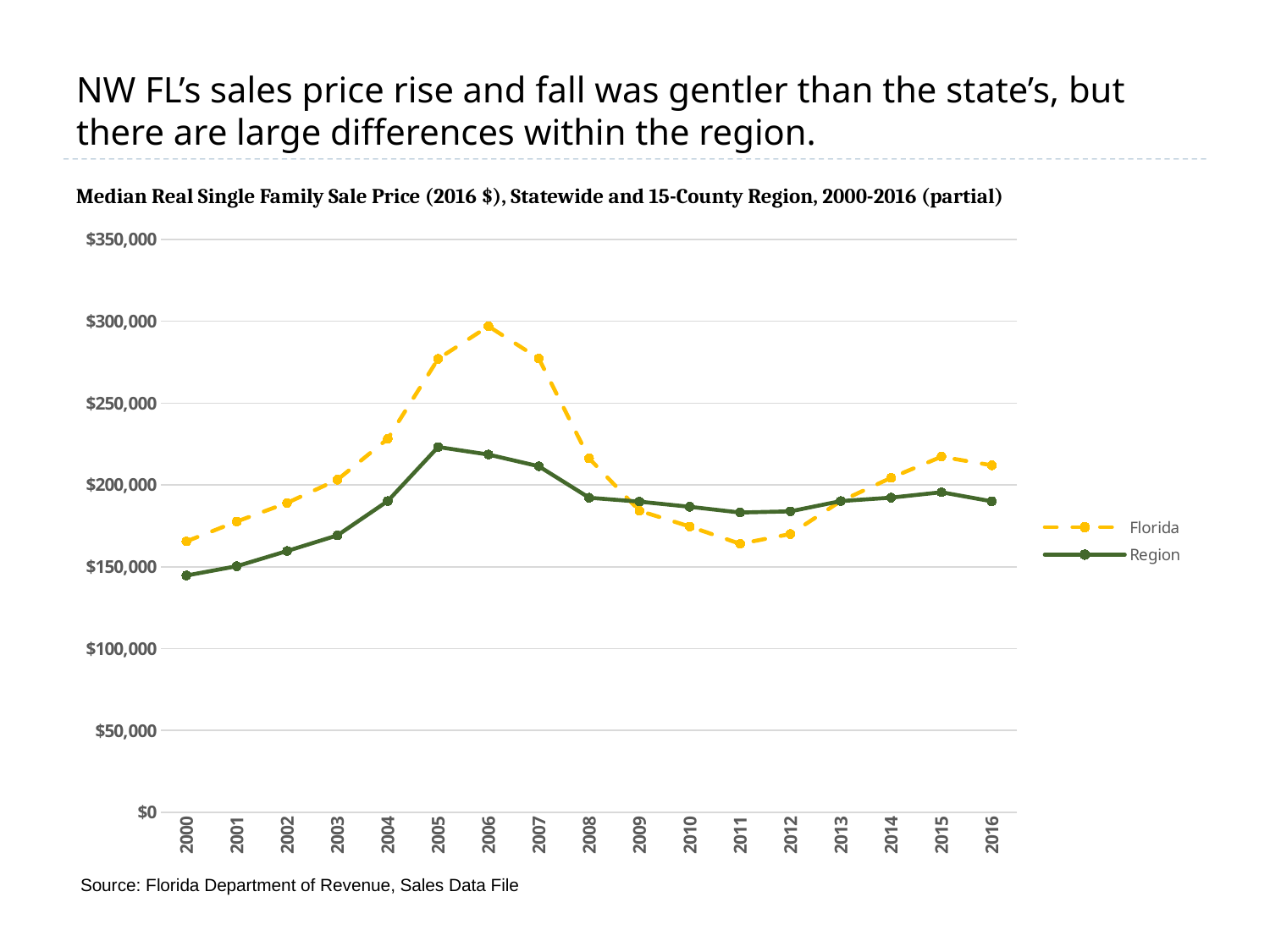
Is the Region value for 2005 greater or less than $200,000? greater Is the Region value for 2000 greater or less than $150,000? less Does the Florida series rise or fall between 2006 and 2011? fall Is the Florida value for 2006 greater or less than $250,000? greater In which year does the Florida series reach its highest value? 2006 Which series is drawn with a dashed line? Florida How many series does the legend list? 2 In which year is the Region series at its lowest value? 2000 In 2011, which series has the higher value, Florida or Region? Region How many years are plotted along the x axis? 17 What kind of chart is shown on the slide? line chart In 2006, which series has the higher value, Florida or Region? Florida